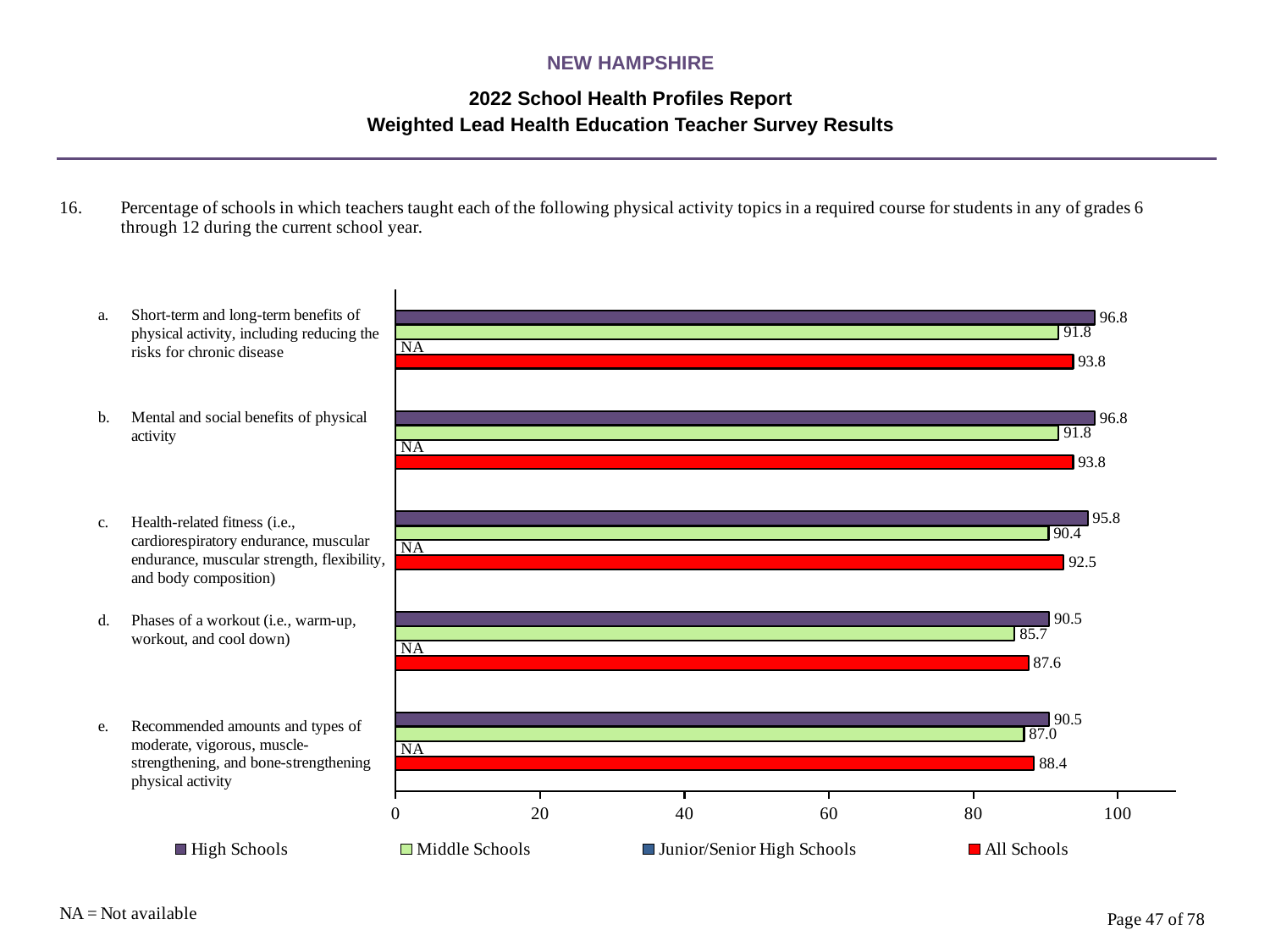
Which is larger, the All Schools value for topic d or the All Schools value for topic e? Topic e (88.4) Which topic has the lowest Middle Schools value? d. Phases of a workout How many physical activity topics are plotted on the chart? 5 Which topic has the lowest All Schools value? d. Phases of a workout What is the All Schools value for topic c, health-related fitness? 92.5 What is the Junior/Senior High Schools value for topic e, recommended amounts and types of physical activity? NA What is the difference between the High Schools and Middle Schools values for topic c, health-related fitness? 5.4 What is the difference between the All Schools values for topic a and topic e? 5.4 How many series does the legend list? 4 What is the Middle Schools value for topic d, phases of a workout? 85.7 What is the High Schools value for topic a, short-term and long-term benefits of physical activity? 96.8 What kind of chart is shown on the slide? Bar chart